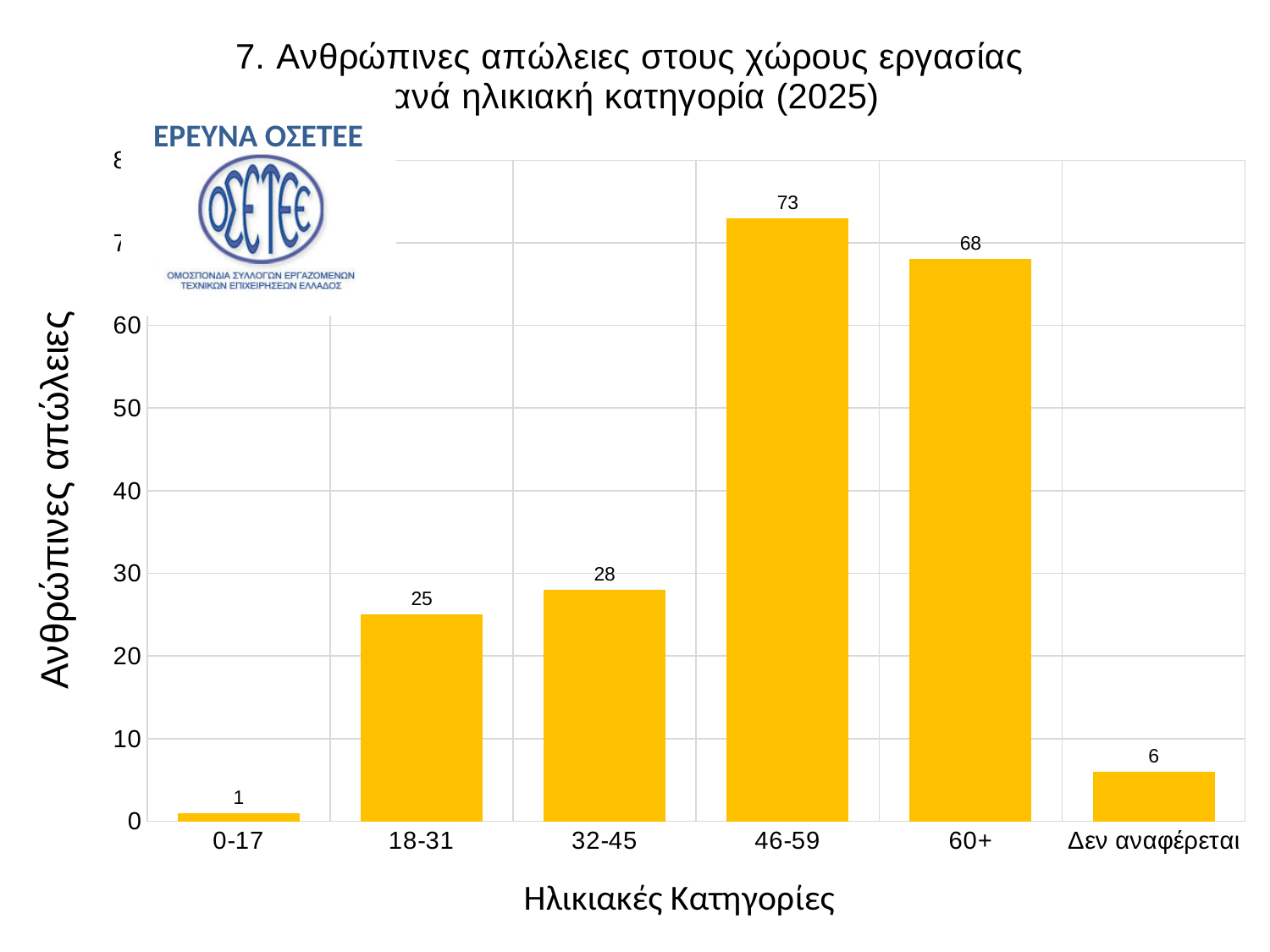
How many age categories are shown on the x axis? 6 Which age category has the highest number of losses? 46-59 What is the value for the 46-59 age category? 73 What is the value for the 'Δεν αναφέρεται' category? 6 What is the label of the x axis? Ηλικιακές Κατηγορίες What is the difference between the values for 46-59 and 60+? 5 What is the difference between the values for 32-45 and 18-31? 3 What is the value for the 18-31 age category? 25 Which age category has the lowest number of losses? 0-17 What kind of chart is shown on the slide? bar chart Is the value for 60+ greater or less than 50? greater Which is larger, the value for 60+ or the value for 32-45? 60+